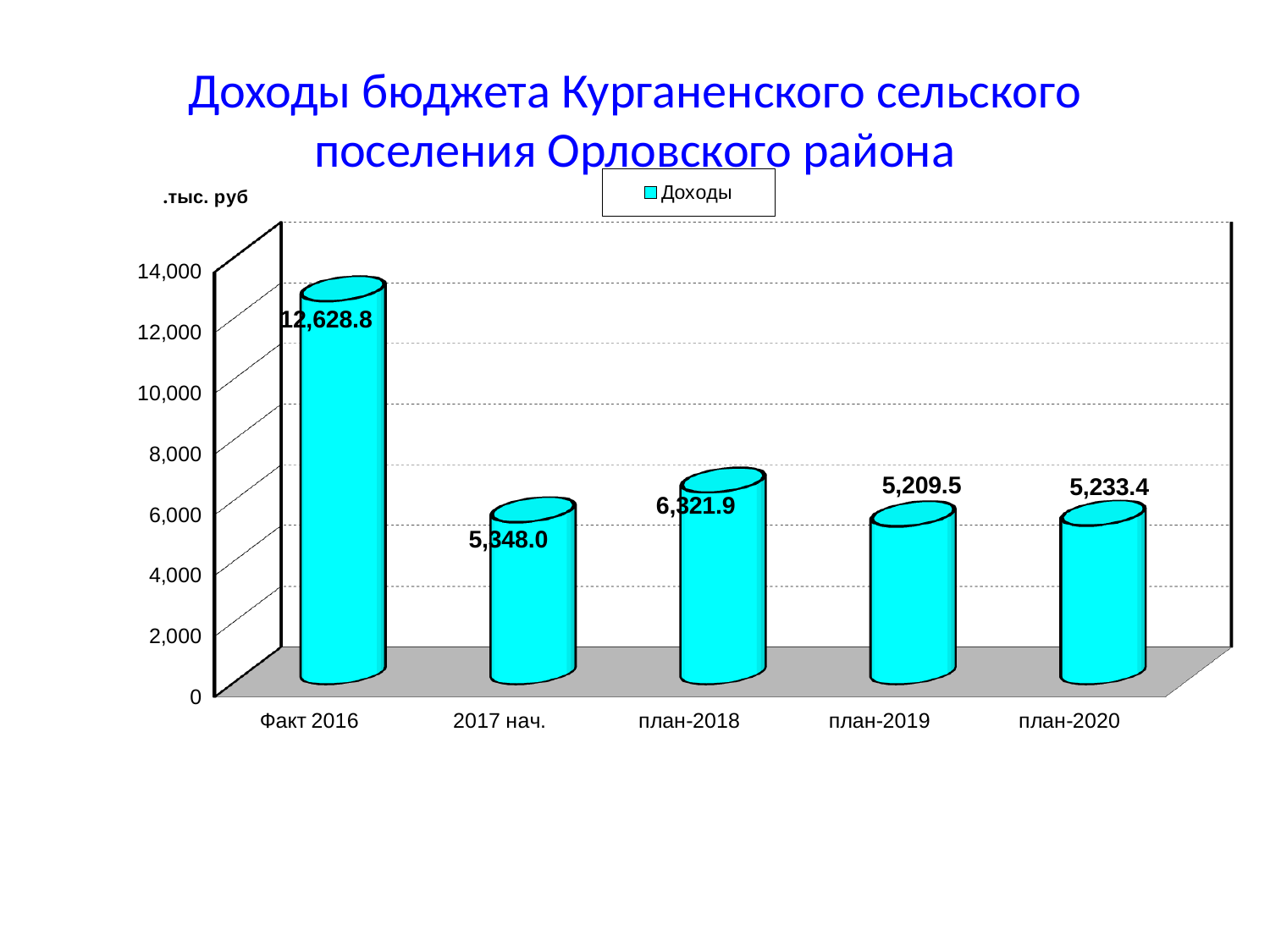
What kind of chart is shown on the slide? bar chart What is the value for план-2020? 5,233.4 What is the value for план-2018? 6,321.9 What is the difference between the values for Факт 2016 and 2017 нач.? 7,280.8 How many categories are shown on the x axis? 5 What is the value for Факт 2016? 12,628.8 Which category has the highest value? Факт 2016 Is the value for Факт 2016 greater or less than 12,000? greater What is the difference between the values for план-2018 and план-2019? 1,112.4 Which category has the lowest value? план-2019 What series name is listed in the legend? Доходы Which is larger, the value for план-2018 or the value for план-2020? план-2018